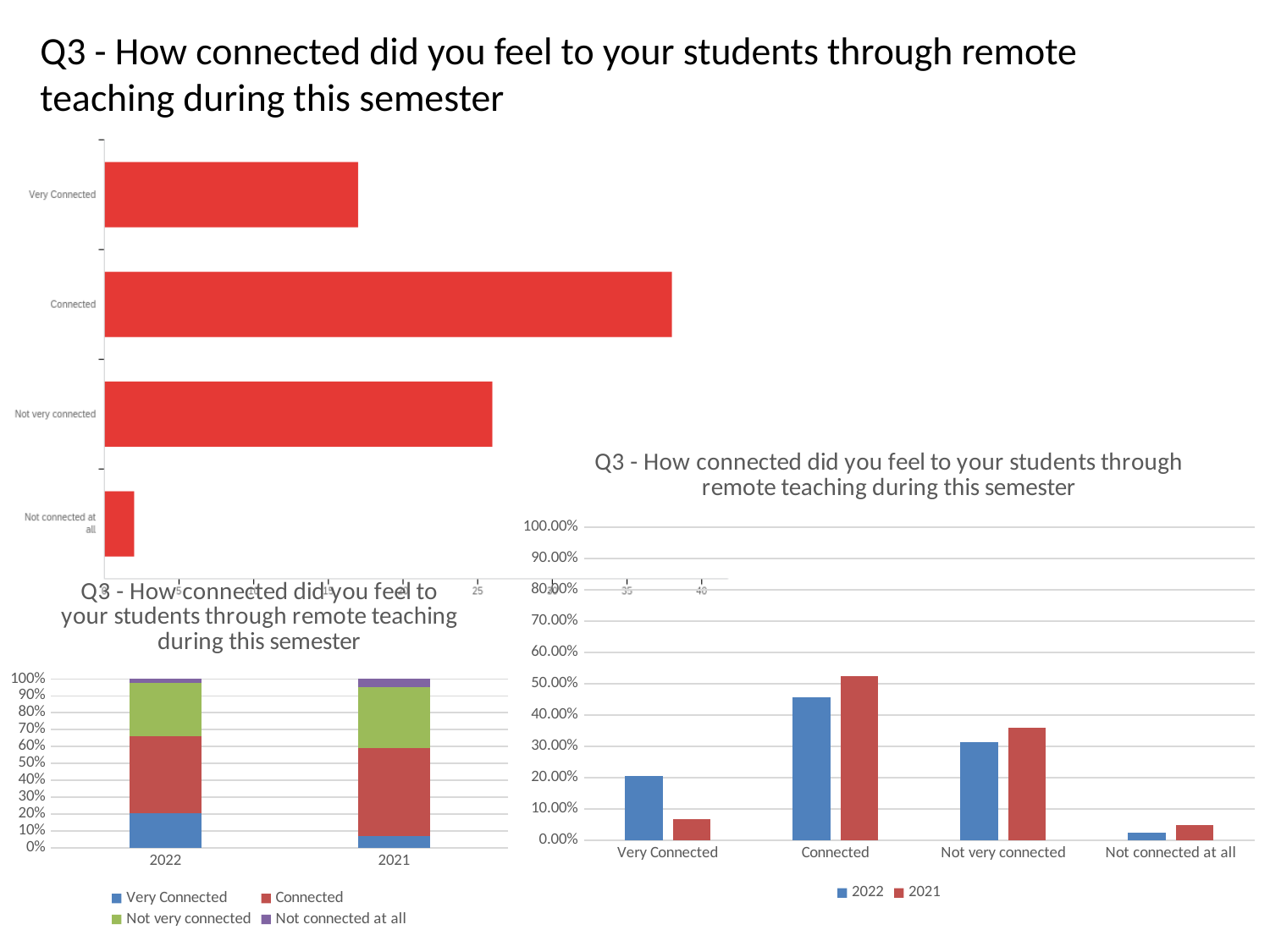
In the right-hand chart, how many series does the legend list? 2 In the bottom-left stacked chart, how many series does the legend list? 4 In the top-left horizontal bar chart, is the value for Connected greater or less than 30? greater In the top-left horizontal bar chart, which category has the shortest bar? Not connected at all In the bottom-left stacked chart, how many categories are shown on the x axis? 2 In the right-hand chart, is the 2022 value for Connected greater or less than 50.00%? less In the top-left horizontal bar chart, is the value for Very Connected greater or less than 20? less In the top-left horizontal bar chart, how many categories are shown? 4 In the right-hand chart, which is larger for Very Connected, 2022 or 2021? 2022 What kind of chart is the chart on the right of the slide? bar chart In the top-left horizontal bar chart, which category has the longest bar? Connected